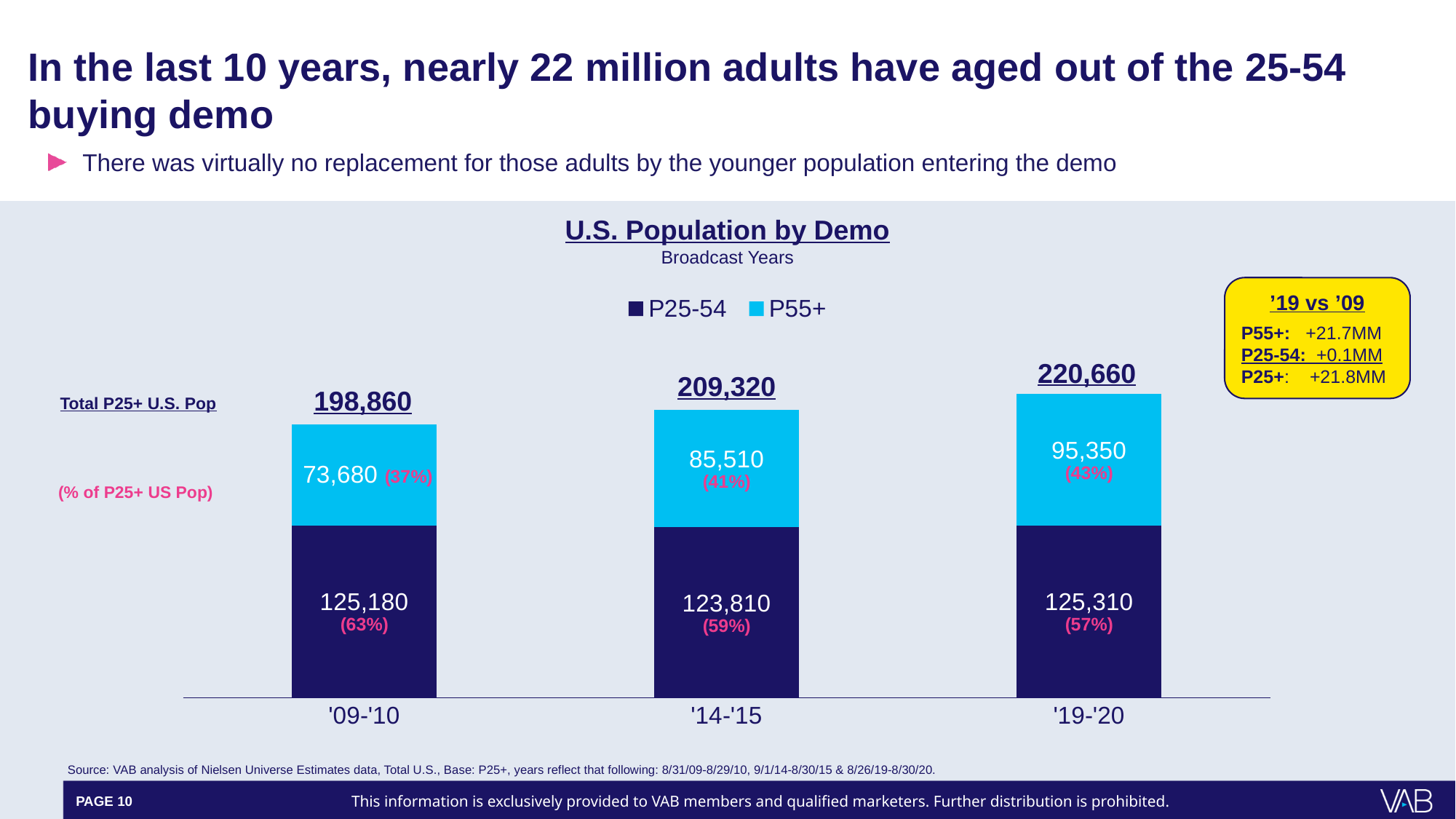
What is the total P25+ U.S. population shown for '19-'20? 220,660 How many broadcast years are shown on the x axis? 3 What kind of chart is shown on the slide? Stacked bar chart Which broadcast year has the highest P55+ value? '19-'20 What is the total P25+ U.S. population shown for '14-'15? 209,320 What is the P55+ value for '14-'15? 85,510 What is the P25-54 value for '09-'10? 125,180 What is the P55+ value for '19-'20? 95,350 How many series does the legend list? 2 What is the difference between the P55+ values for '19-'20 and '09-'10? 21,670 Is the P25-54 value or the P55+ value larger for '19-'20? P25-54 Which broadcast year has the lowest P25-54 value? '14-'15